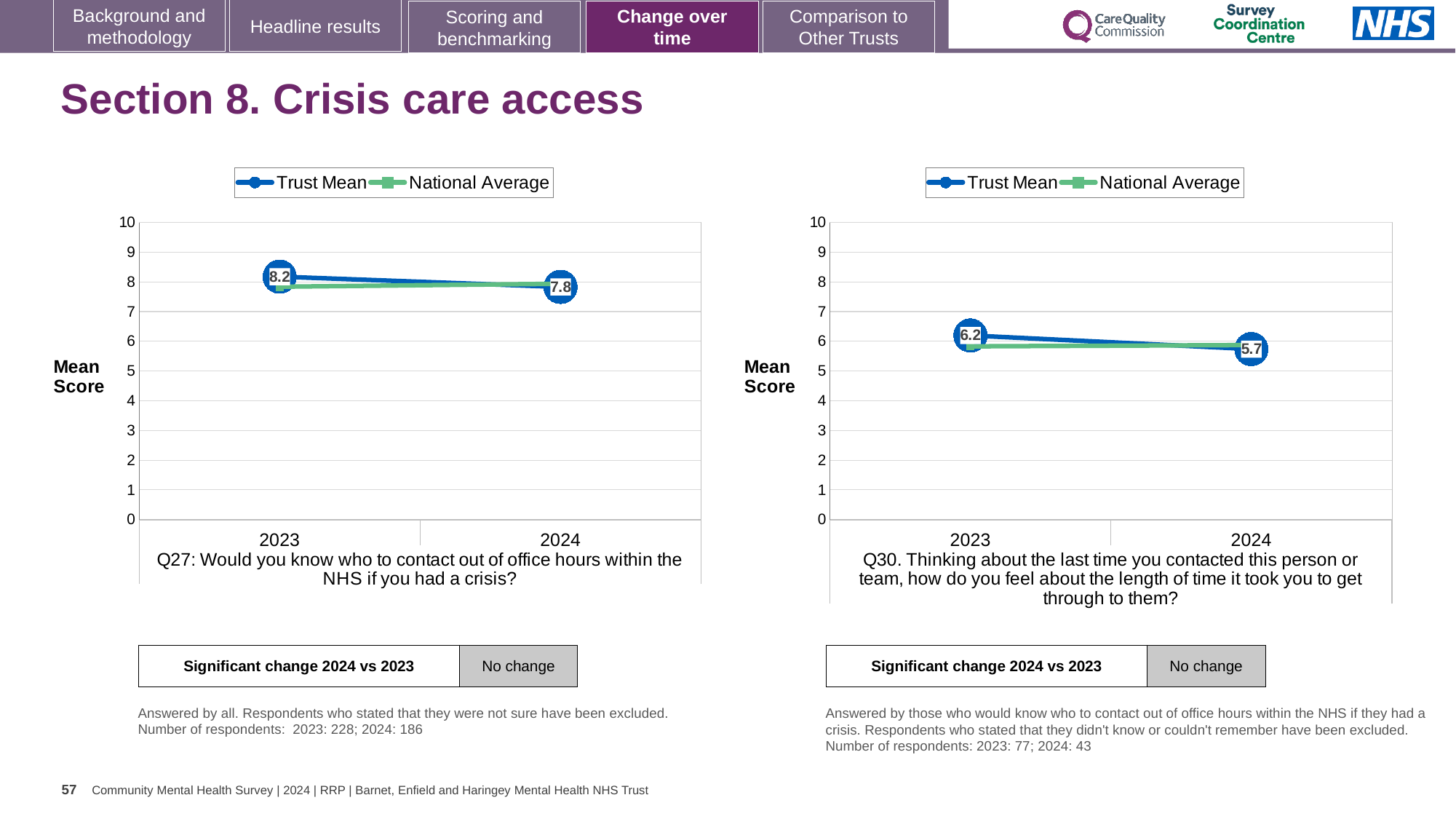
On the right chart (Q30), what is the difference between the Trust Mean in 2023 and 2024? 0.5 On the right chart (Q30), is the National Average for 2023 greater or less than 7? less What kind of chart is the left chart (Q27)? line chart On the left chart (Q27), what is the Trust Mean for 2024? 7.8 On the right chart (Q30), what is the Trust Mean for 2023? 6.2 On the right chart (Q30), what is the Trust Mean for 2024? 5.7 On the right chart (Q30), does the Trust Mean rise or fall from 2023 to 2024? fall Which series is shown in green on the left chart (Q27)? National Average How many years are shown on the x axis of the right chart (Q30)? 2 On the left chart (Q27), what is the Trust Mean for 2023? 8.2 How many series does the legend of the left chart (Q27) list? 2 On the left chart (Q27), by how much did the Trust Mean change from 2023 to 2024? 0.4